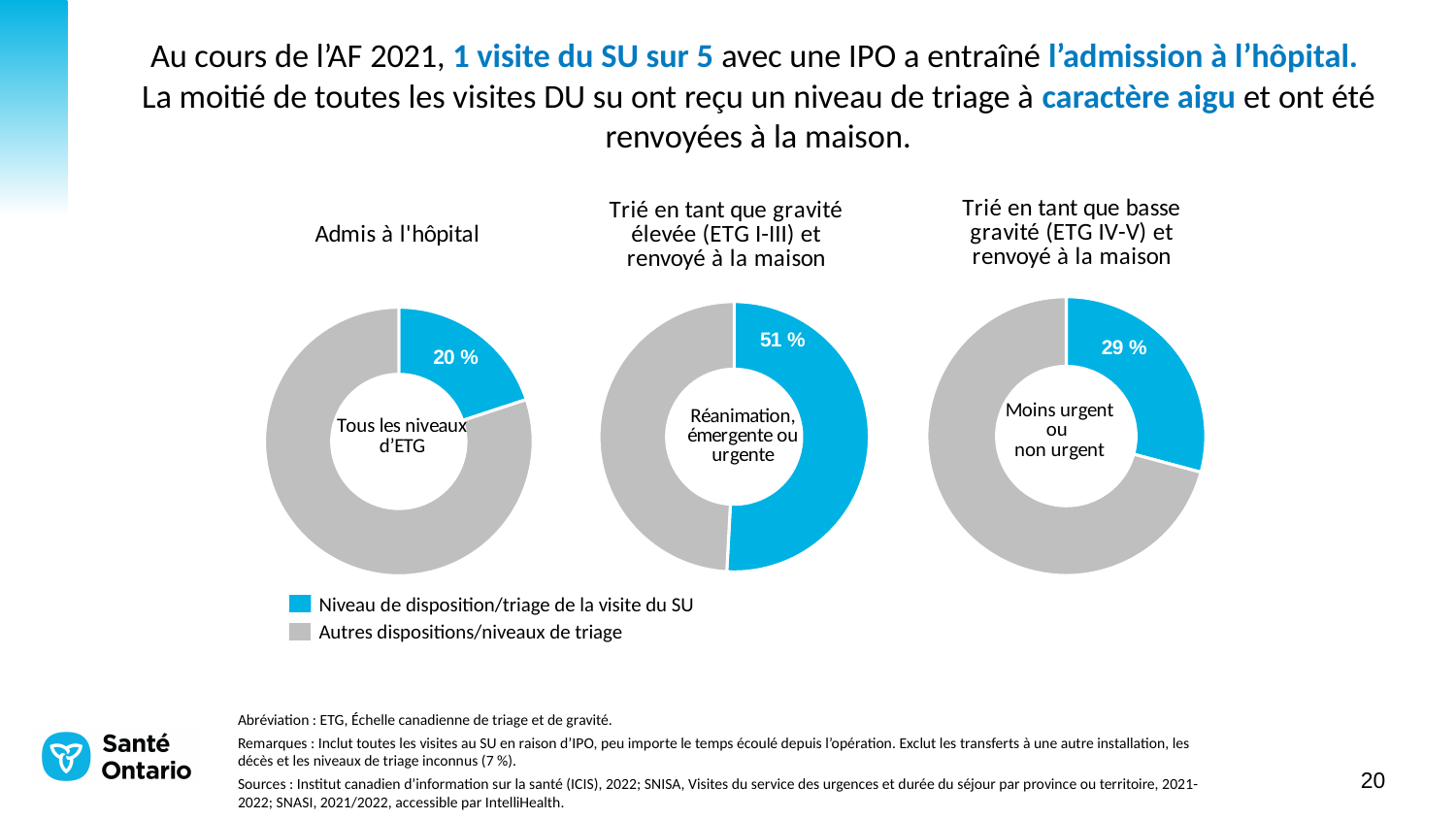
What label appears in the centre of the "Admis à l'hôpital" chart? Tous les niveaux d'ETG In the chart titled "Trié en tant que gravité élevée (ETG I-III) et renvoyé à la maison", what percentage is shown for the blue slice? 51 % What does the blue colour represent according to the legend? Niveau de disposition/triage de la visite du SU In the chart titled "Trié en tant que basse gravité (ETG IV-V) et renvoyé à la maison", what percentage is shown for the blue slice? 29 % Which of the three charts on the slide shows the lowest labelled percentage? Admis à l'hôpital In the chart titled "Admis à l'hôpital", what percentage is shown for the blue slice? 20 % Which is larger: the percentage in the "Trié en tant que basse gravité (ETG IV-V) et renvoyé à la maison" chart or the percentage in the "Admis à l'hôpital" chart? Trié en tant que basse gravité (ETG IV-V) et renvoyé à la maison What is the difference between the percentage in the "Trié en tant que gravité élevée (ETG I-III) et renvoyé à la maison" chart and the percentage in the "Admis à l'hôpital" chart? 31 % Which of the three charts on the slide shows the highest labelled percentage? Trié en tant que gravité élevée (ETG I-III) et renvoyé à la maison What kind of chart is used on this slide? Donut (pie) chart How many charts are shown on the slide? 3 How many entries does the legend list? 2